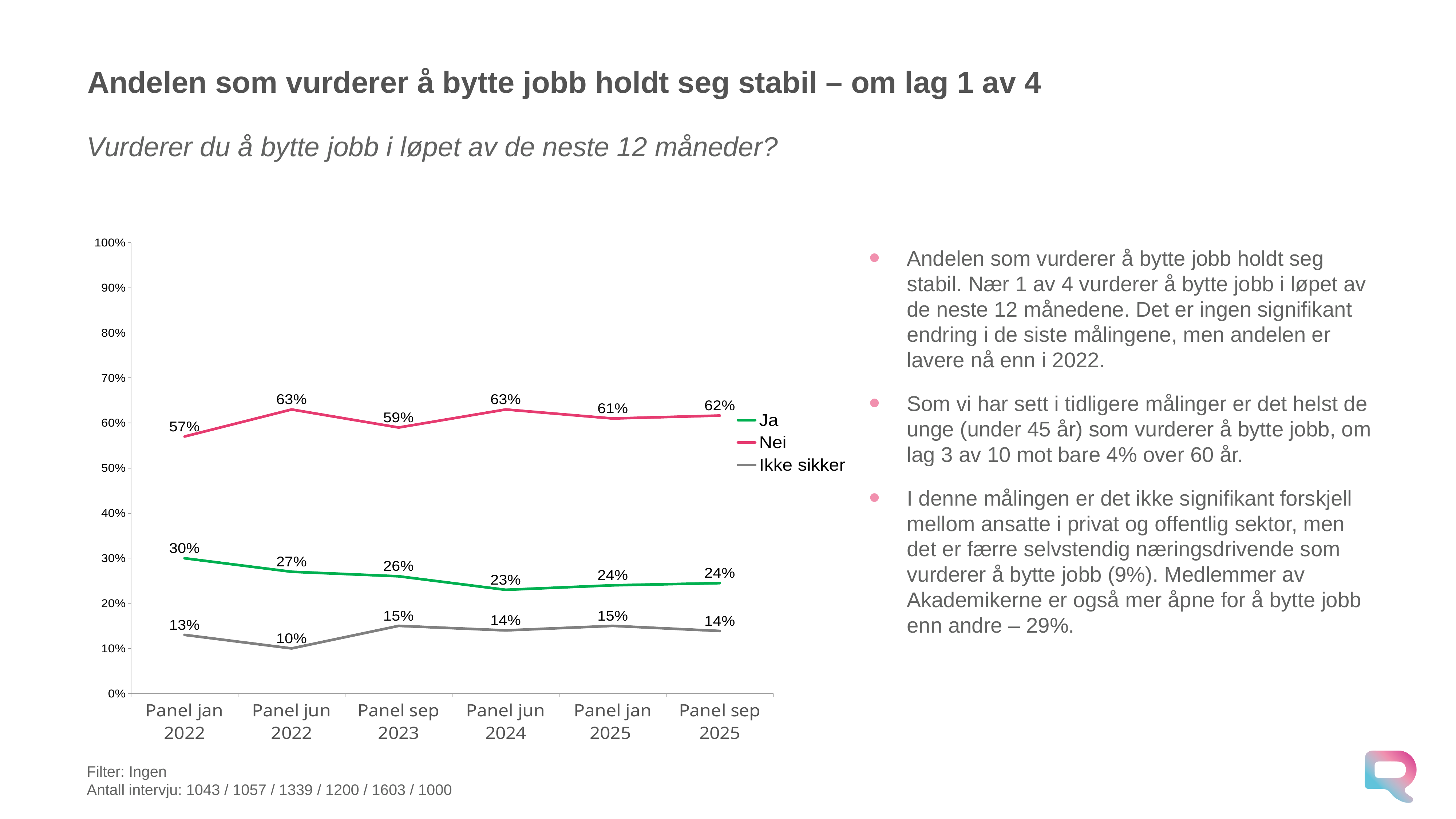
What is the value for Ikke sikker at Panel jun 2022? 10% What kind of chart is shown on the slide? Line chart Does the Ja series generally rise or fall from Panel jan 2022 to Panel jun 2024? Fall At which time point is the Ja series lowest? Panel jun 2024 How many time points are plotted along the x axis? 6 Which is larger: the Nei value at Panel jun 2022 or at Panel jan 2025? Panel jun 2022 At which time point is the Ja series highest? Panel jan 2022 What colour is the line for the Nei series? Pink What is the difference between the Ja value at Panel jan 2022 and at Panel sep 2025? 6 percentage points What is the value for Nei at Panel sep 2023? 59% What is the value for Ja at Panel jan 2022? 30% How many series does the legend list? 3